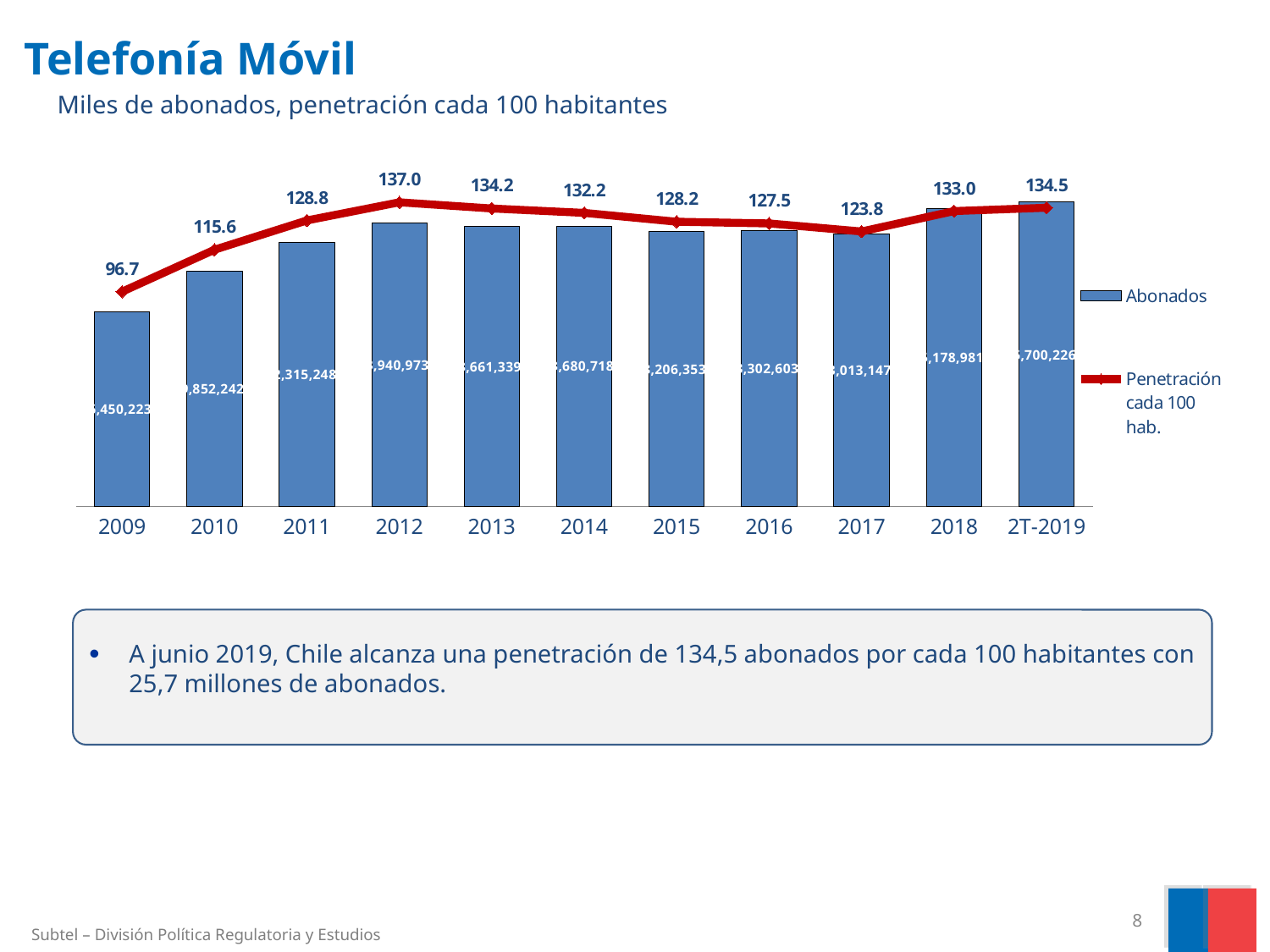
Does the penetración cada 100 hab. rise or fall from 2009 to 2012? rise Which year has the higher penetración cada 100 hab., 2013 or 2014? 2013 In which year is the penetración cada 100 hab. lowest? 2009 How many time periods are shown on the x axis of the chart? 11 What is the penetración cada 100 hab. value for 2009? 96.7 What is the penetración cada 100 hab. value for 2012? 137.0 By how much did the penetración cada 100 hab. increase from 2017 to 2018? 9.2 What is the penetración cada 100 hab. value for 2T-2019? 134.5 In which year is the penetración cada 100 hab. highest? 2012 What is the difference between the penetración values for 2012 and 2009? 40.3 How many series does the chart legend list? 2 What is the penetración cada 100 hab. value for 2017? 123.8